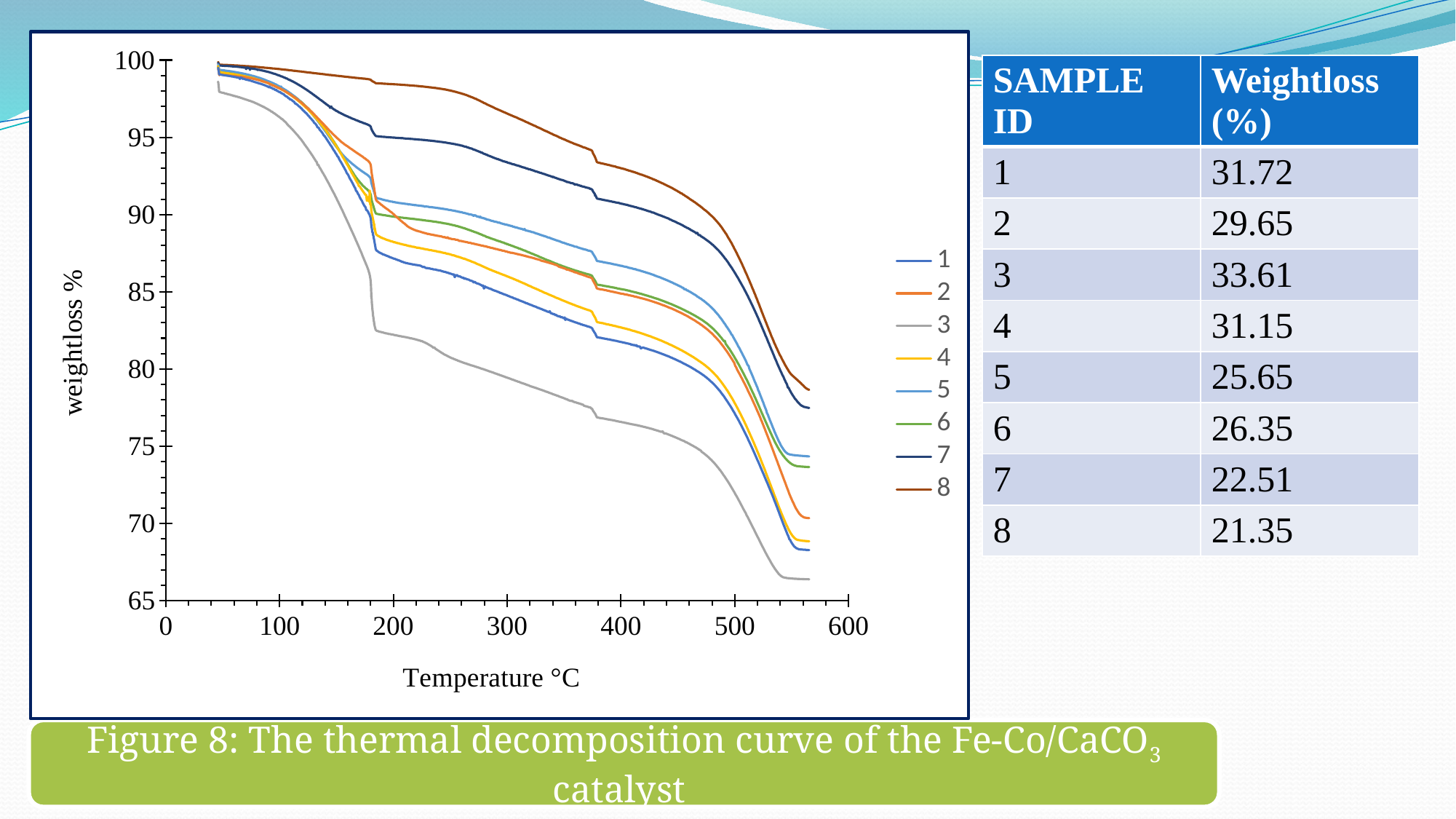
Is the value for series 3 at 200 °C greater or less than 85? less What kind of chart is shown on the slide? line chart Do the weightloss % curves rise or fall as temperature increases along the x axis? fall How many series does the chart legend list? 8 What is the label of the y axis of the chart? weightloss % Is the value for series 7 at 300 °C greater or less than 90? greater What is the label of the x axis of the chart? Temperature °C Which series ends at the lowest weightloss % at the right end of the chart? 3 Is the value for series 3 at 500 °C greater or less than 75? less At 300 °C, which series has the higher weightloss %: series 7 or series 1? 7 Which series stays highest on the chart across the temperature range? 8